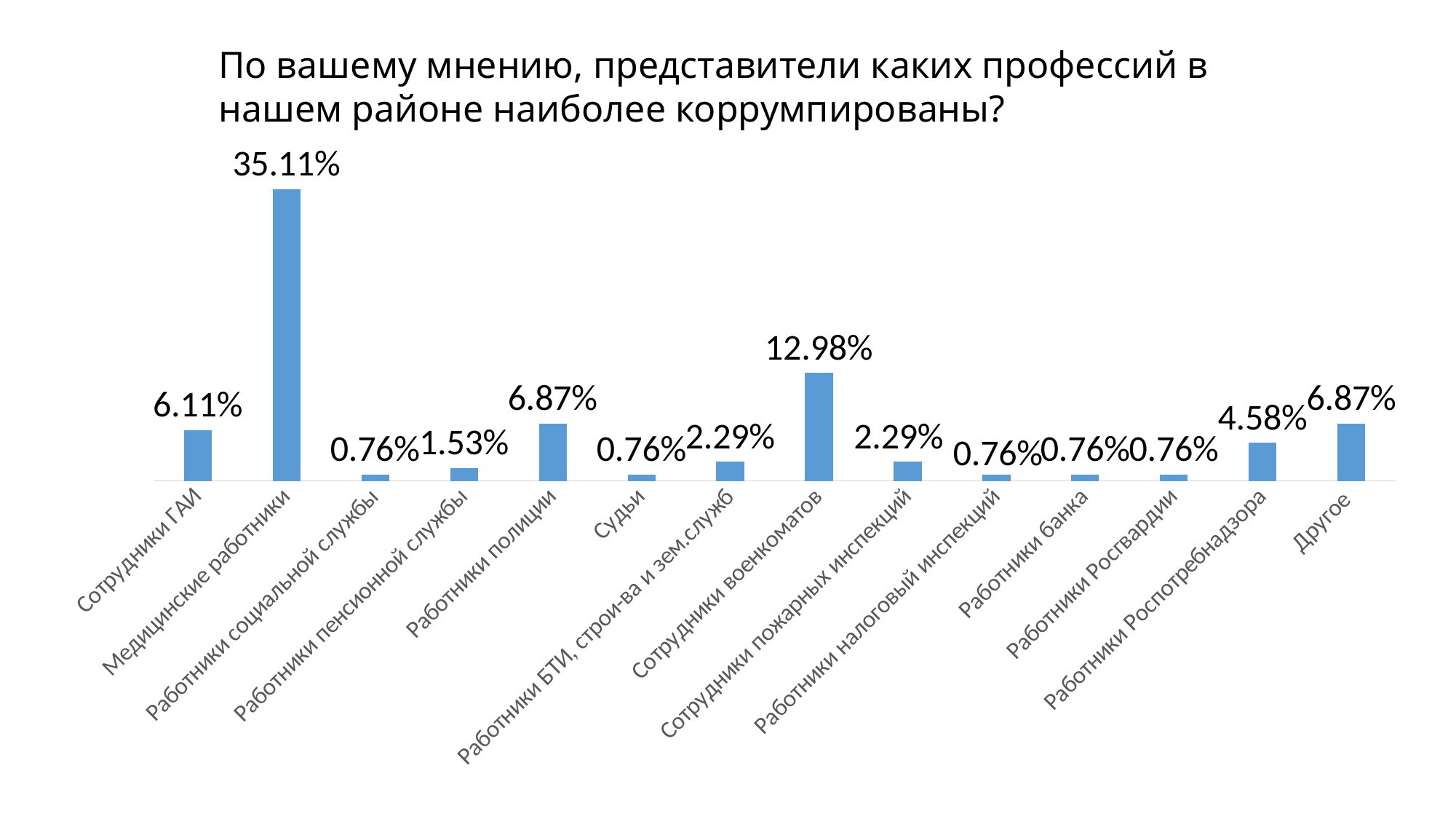
How many categories are shown on the x axis? 14 What is the value for Медицинские работники? 35.11% What is the value for Работники пенсионной службы? 1.53% What is the difference between the values for Работники полиции and Сотрудники ГАИ? 0.76% What is the difference between the values for Медицинские работники and Сотрудники военкоматов? 22.13% Which is larger, the value for Работники Роспотребнадзора or the value for Сотрудники пожарных инспекций? Работники Роспотребнадзора What is the value for Работники Роспотребнадзора? 4.58% Which category has the highest value? Медицинские работники Which is larger, the value for Работники полиции or the value for Сотрудники ГАИ? Работники полиции What is the value for Сотрудники военкоматов? 12.98% What type of chart is shown on the slide? Bar chart What is the title of the chart? По вашему мнению, представители каких профессий в нашем районе наиболее коррумпированы?